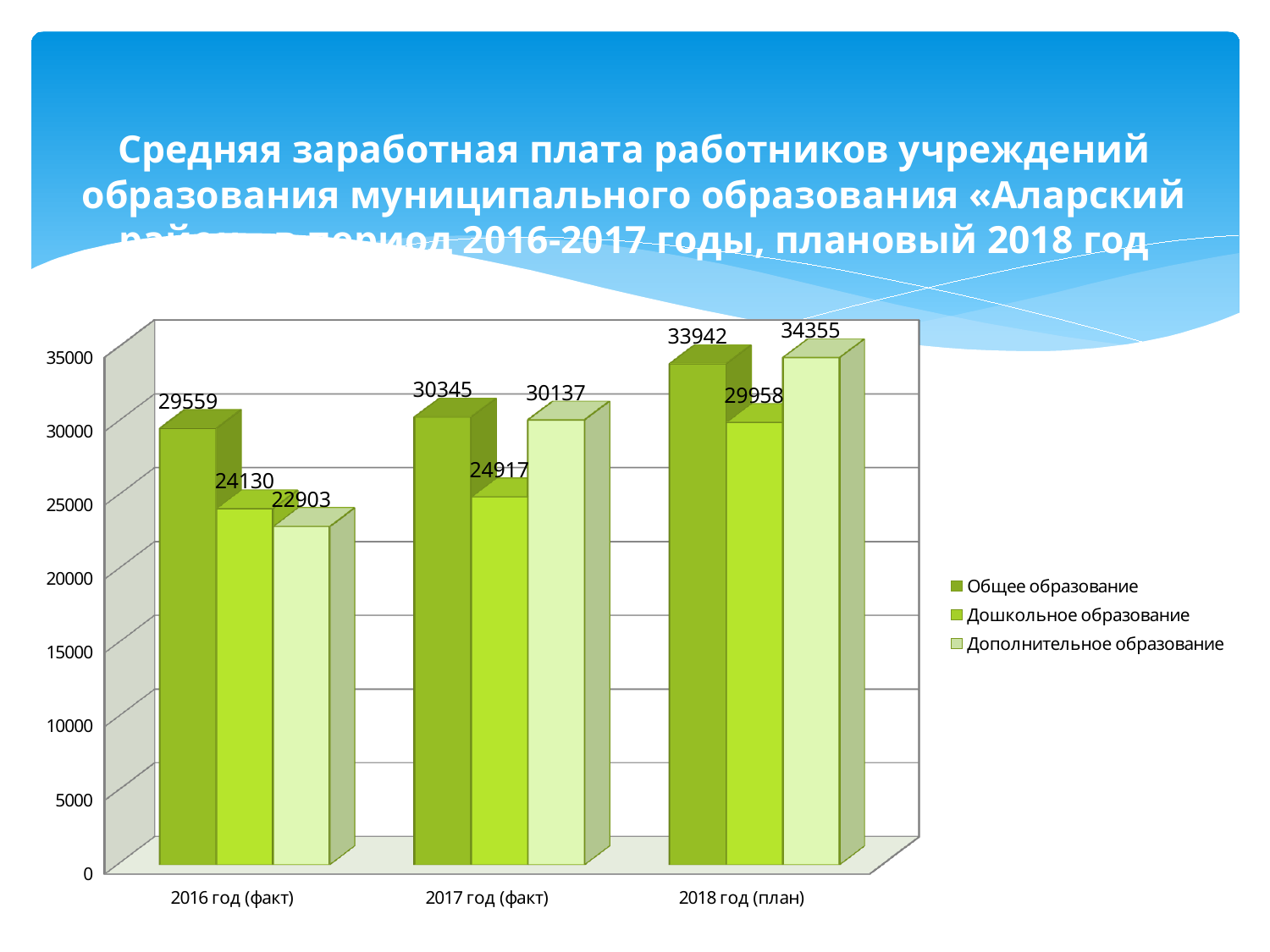
Does the value for Дошкольное образование rise or fall from 2016 год (факт) to 2018 год (план)? rise Which series has the highest value in 2018 год (план)? Дополнительное образование How many series does the legend list? 3 What is the value for Дополнительное образование in 2018 год (план)? 34355 What kind of chart is shown on the slide? bar chart Which series has the lowest value in 2016 год (факт)? Дополнительное образование Which is larger in 2017 год (факт): Общее образование or Дополнительное образование? Общее образование How many categories are shown on the x axis? 3 What is the difference between Общее образование and Дошкольное образование in 2018 год (план)? 3984 Is the value for Дошкольное образование in 2016 год (факт) greater or less than 25000? less What is the value for Дошкольное образование in 2017 год (факт)? 24917 What is the value for Общее образование in 2016 год (факт)? 29559